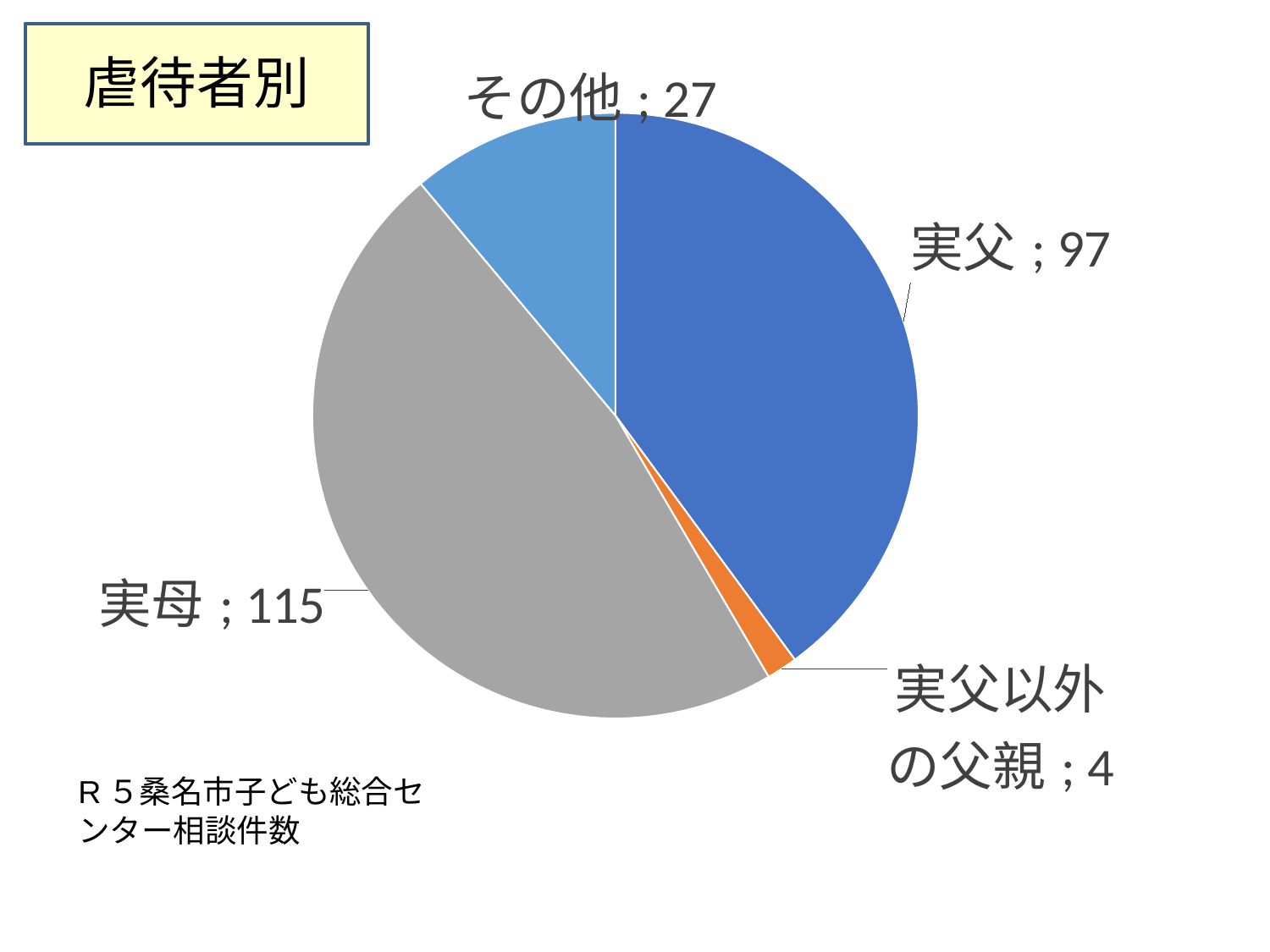
What is the value for 実父 in the pie chart? 97 How many categories are shown in the pie chart? 4 What is the value for 実母 in the pie chart? 115 Which category has the smallest slice in the pie chart? 実父以外の父親 Which is larger, the value for 実父 or the value for その他? 実父 What is the value for 実父以外の父親 in the pie chart? 4 What is the title shown in the box at the top left of the slide? 虐待者別 What is the total of all the values shown in the pie chart? 243 What type of chart is shown on the slide? Pie chart Which category has the largest slice in the pie chart? 実母 What is the difference between the values for 実母 and 実父? 18 What is the value for その他 in the pie chart? 27